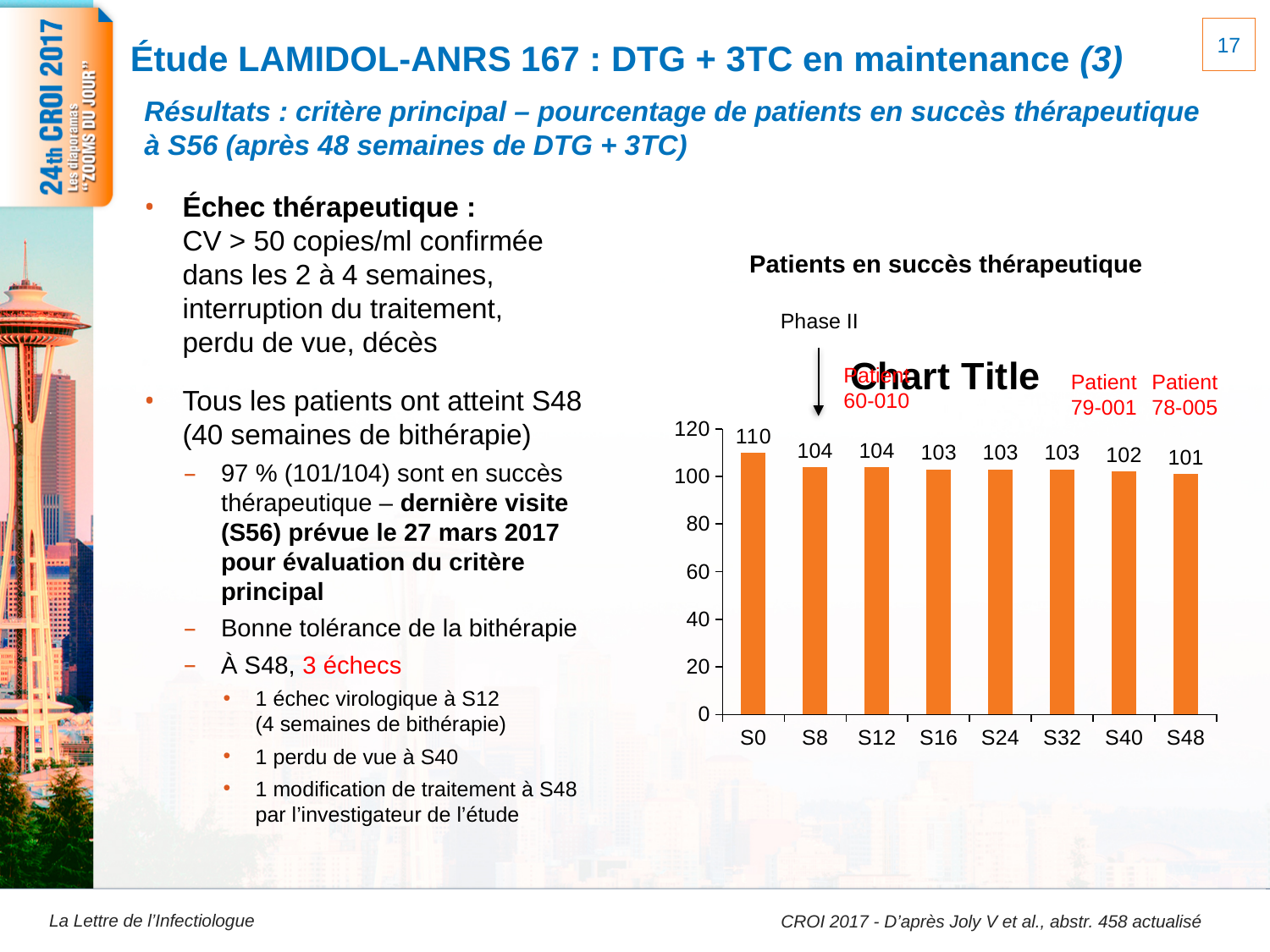
Which category has the lowest value in the chart? S48 What is the difference between the values for S8 and S40? 2 What is the difference between the values for S0 and S48? 9 Which category has the highest value in the chart? S0 How many categories are shown on the x axis of the chart? 8 What kind of chart is shown on the slide? Bar chart What is the value for S16 in the chart? 103 What is the value for S48 in the chart? 101 What is the value for S40 in the chart? 102 Which is larger, the value for S0 or the value for S8? S0 Do the values rise or fall from S0 to S48 along the x axis? Fall What is the value for S0 in the chart? 110